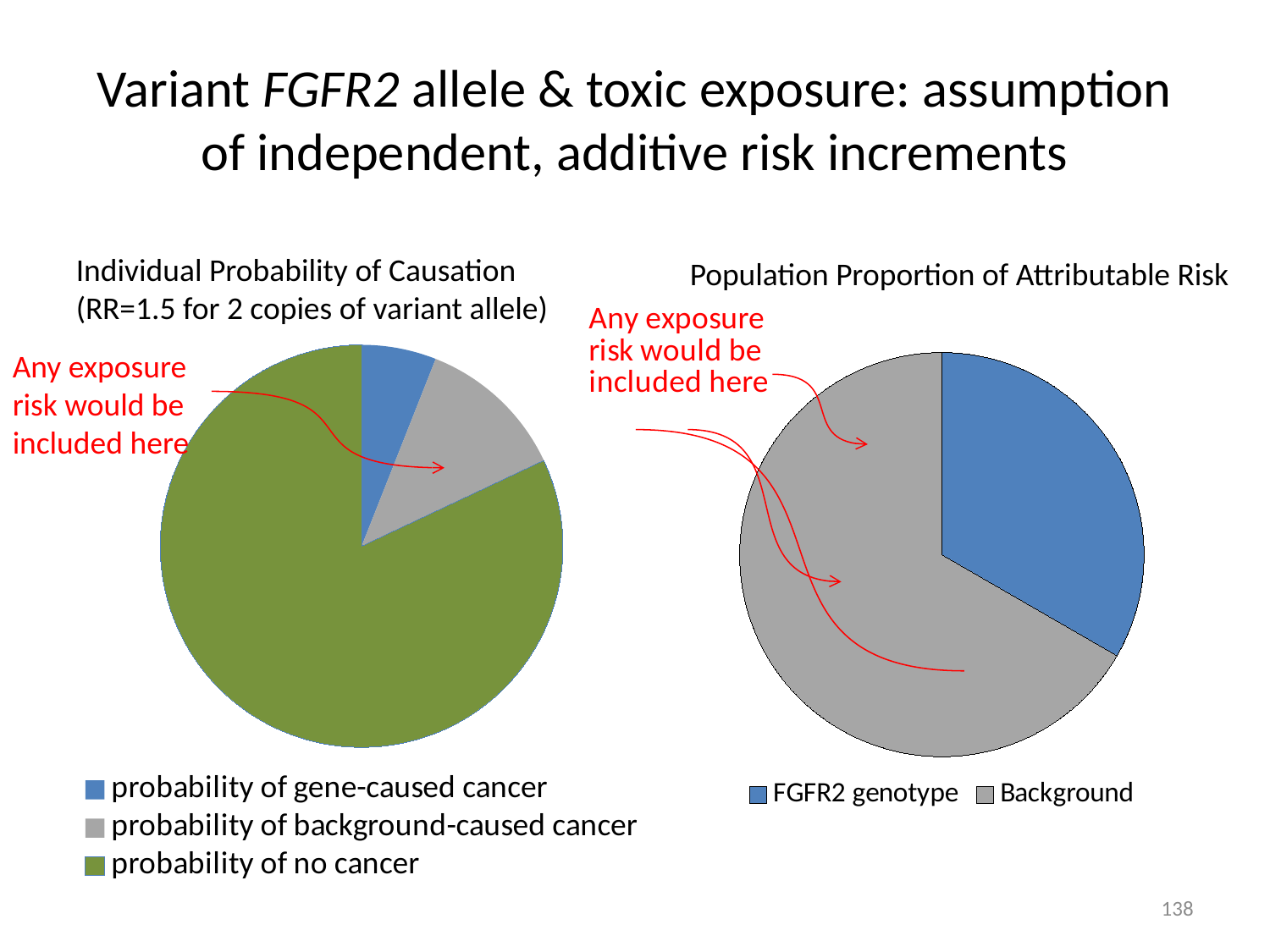
In the 'Individual Probability of Causation' chart, which slice is larger: probability of gene-caused cancer or probability of background-caused cancer? probability of background-caused cancer What kind of chart is the 'Population Proportion of Attributable Risk' chart on the right? pie chart In the 'Population Proportion of Attributable Risk' chart, what colour is the FGFR2 genotype slice? blue In the 'Individual Probability of Causation' chart, which slice is the smallest? probability of gene-caused cancer In the 'Population Proportion of Attributable Risk' chart, which slice is larger: FGFR2 genotype or Background? Background How many entries does the legend of the 'Individual Probability of Causation' chart list? 3 In the 'Individual Probability of Causation' chart, which slice is the largest? probability of no cancer What kind of chart is the 'Individual Probability of Causation' chart on the left? pie chart What is the title of the pie chart on the right side of the slide? Population Proportion of Attributable Risk In the 'Individual Probability of Causation' chart, how many slices does the pie have? 3 In the 'Population Proportion of Attributable Risk' chart, how many slices does the pie have? 2 How many entries does the legend of the 'Population Proportion of Attributable Risk' chart list? 2